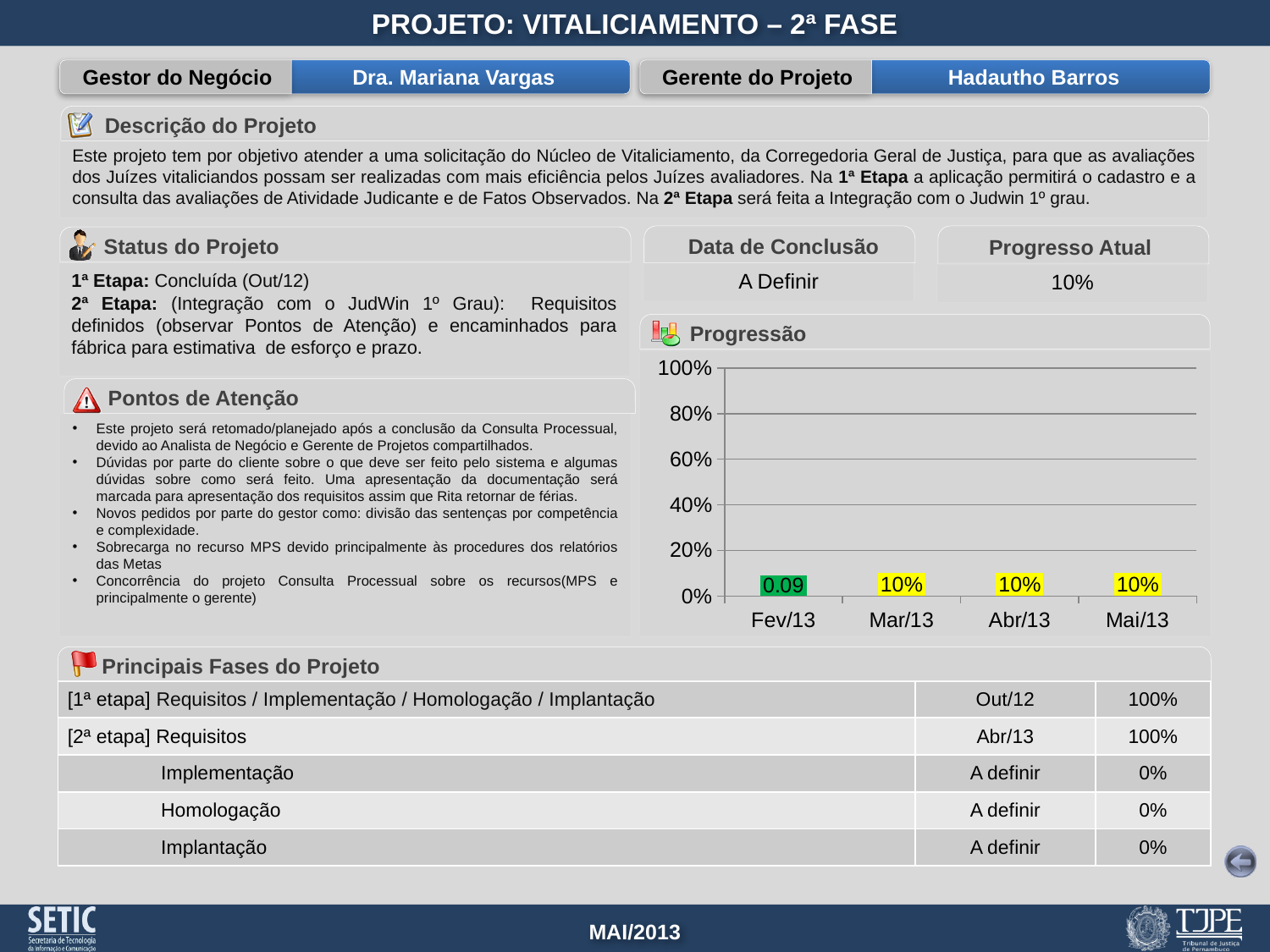
Is the value for Abr/13 in the Progressão chart greater or less than 40%? less What is the value shown for Mar/13 in the Progressão chart? 10% Is the value for Mai/13 in the Progressão chart greater or less than 20%? less Which month is the first category on the x axis of the Progressão chart? Fev/13 What is the highest value shown on the y axis of the Progressão chart? 100% Which month is the last category on the x axis of the Progressão chart? Mai/13 What is the value shown for Mai/13 in the Progressão chart? 10% How many months are shown on the x axis of the Progressão chart? 4 What is the title of the chart on the slide? Progressão What is the value shown for Abr/13 in the Progressão chart? 10% What data label is shown for Fev/13 in the Progressão chart? 0.09